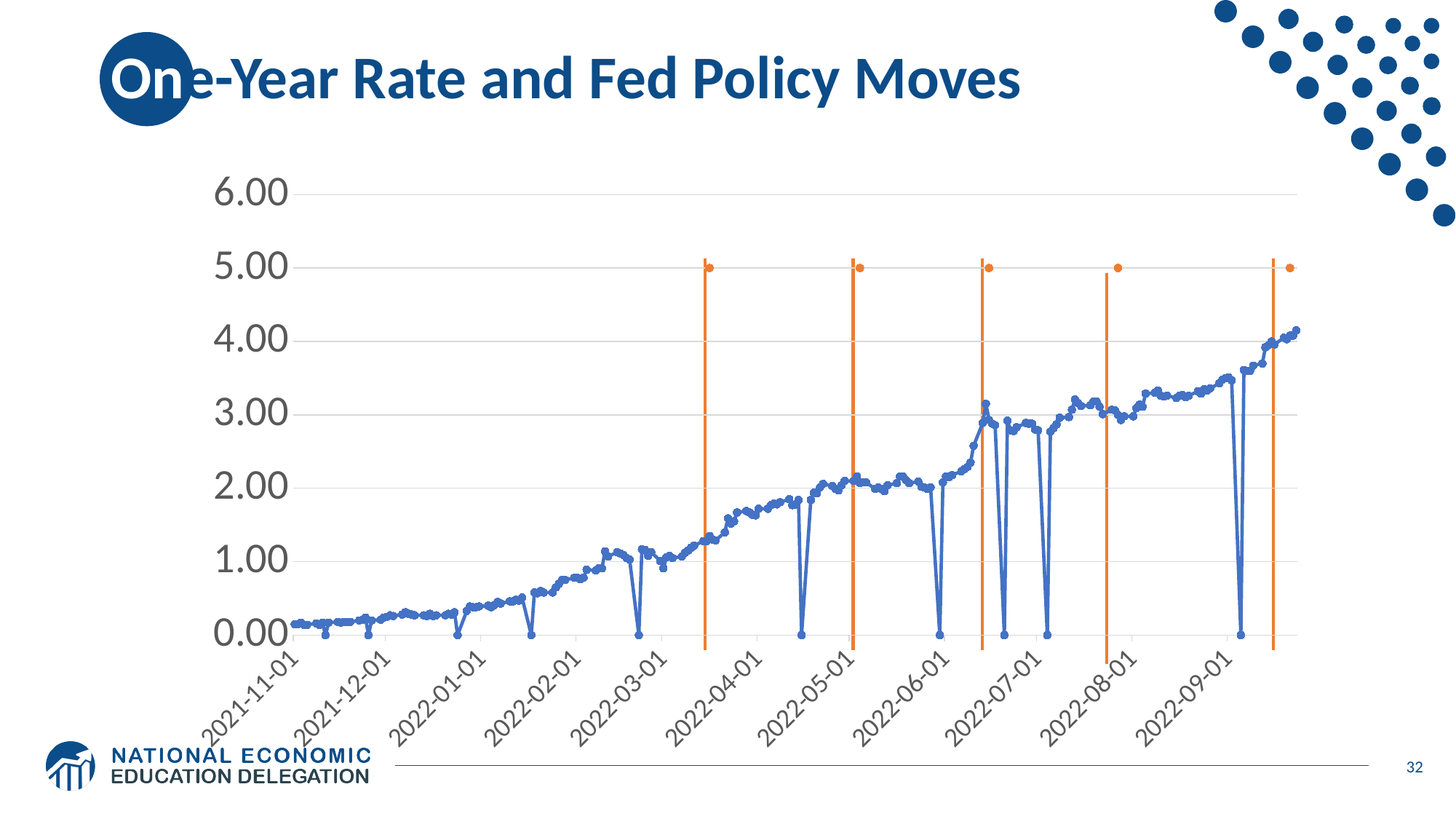
How many date labels are shown on the x axis? 11 How many orange vertical lines marking Fed policy moves are shown on the chart? 5 Is the one-year rate at 2021-12-01 greater or less than 1.00? less Is the one-year rate at 2022-04-01 greater or less than 2.00? less What is the title of the chart? One-Year Rate and Fed Policy Moves Is the one-year rate at 2022-04-01 greater or less than 1.00? greater Overall, does the one-year rate rise or fall from 2021-11-01 to the end of the series? rise What is the highest value shown on the y axis? 6.00 What kind of chart is shown on the slide? line chart